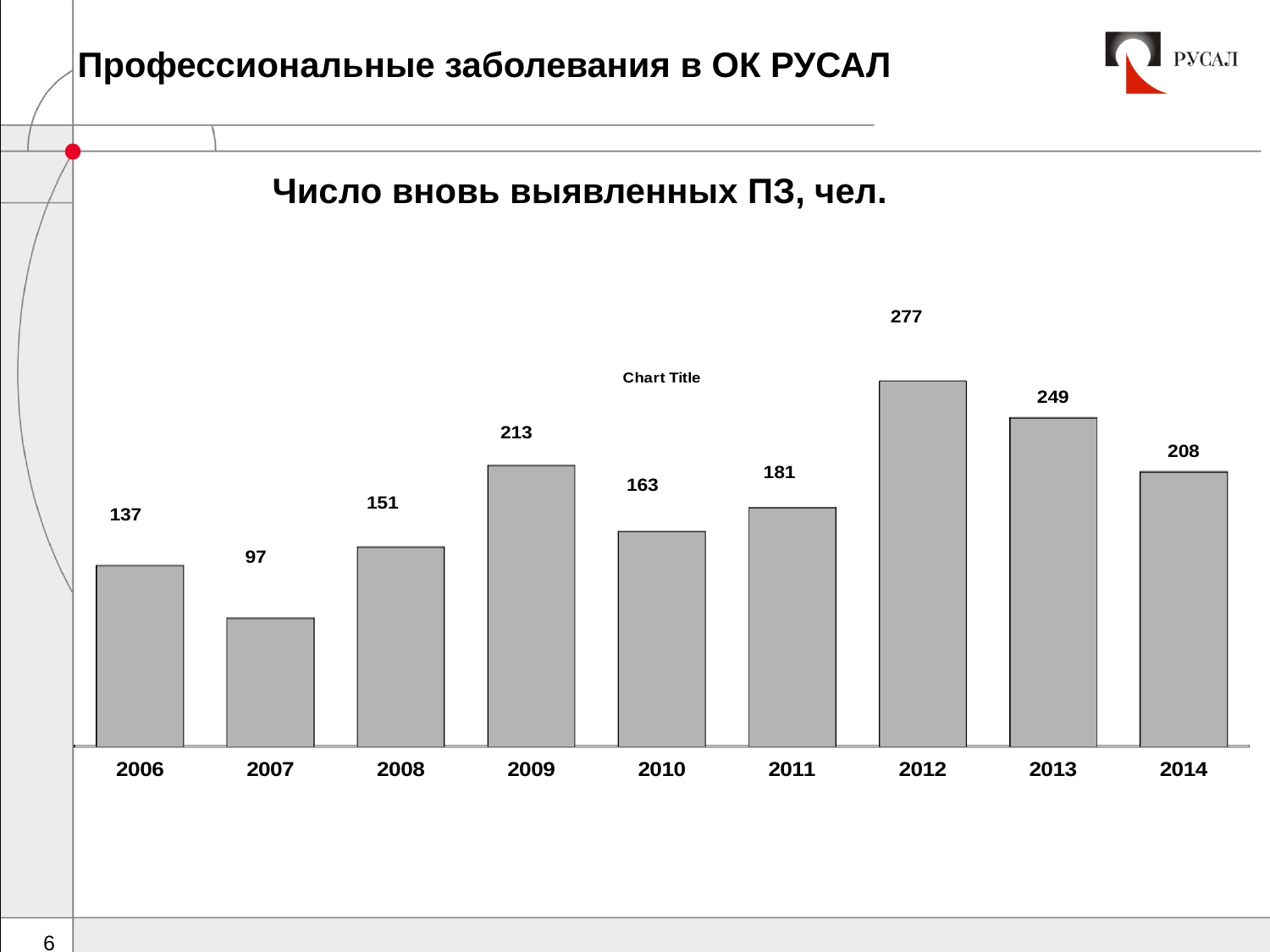
What kind of chart is shown on the slide? bar chart Do the values rise or fall from 2012 to 2014? fall How many years are shown on the x axis? 9 Which year has the highest value? 2012 Which year has the lowest value? 2007 What is the value for 2009? 213 What is the title shown above the chart? Число вновь выявленных ПЗ, чел. What is the difference between the values for 2012 and 2013? 28 Which is larger, the value for 2011 or the value for 2014? 2014 What is the difference between the values for 2009 and 2010? 50 What is the value for 2007? 97 What is the value for 2012? 277